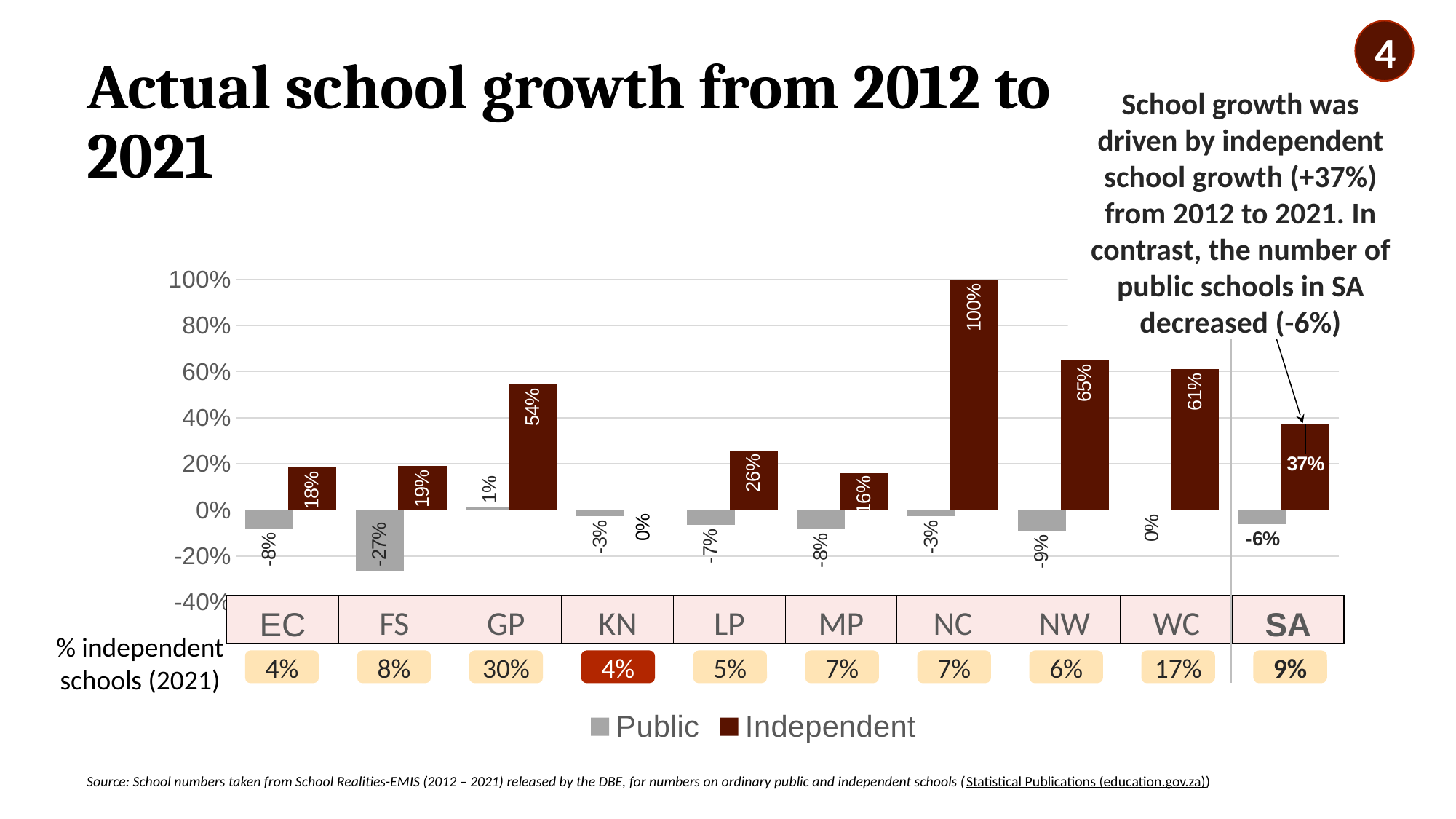
What is the Public value for FS? -27% What is the Independent value for GP? 54% What is the difference between the Independent values for NW and WC? 4% What is the Independent value for NC? 100% How many series does the legend list? 2 Which is larger, the Independent value for GP or the Independent value for LP? GP What kind of chart is shown on the slide? Bar chart Which category has the highest Independent value? NC How many categories are shown on the x axis? 10 What is the Public value for SA? -6% What are the two series named in the legend? Public and Independent Which category has the lowest Public value? FS